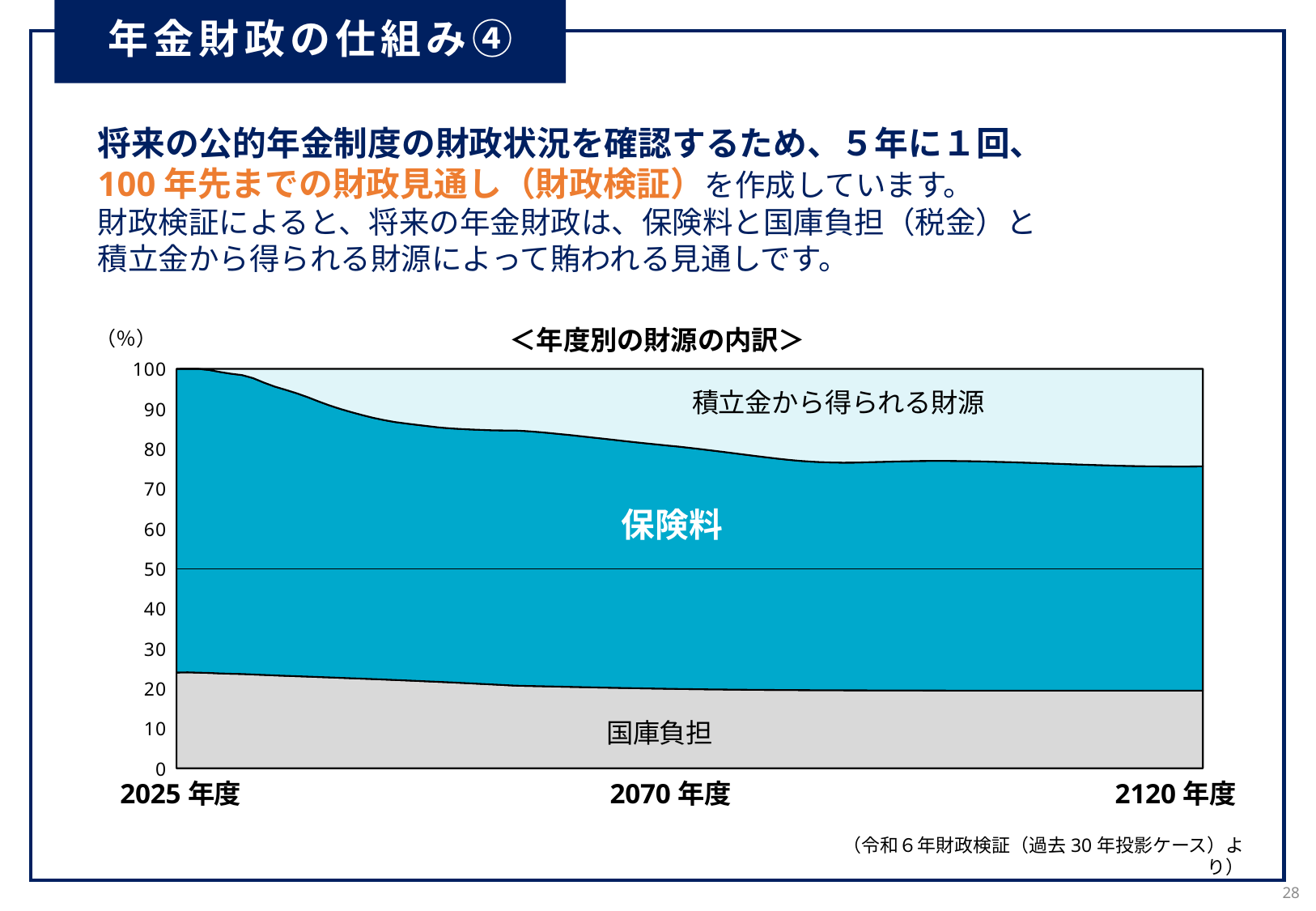
In 2120年度, which is larger: the share of 保険料 or the share of 国庫負担? 保険料 Does the share of 保険料 rise or fall from 2025年度 to 2120年度? Fall What kind of chart is shown on the slide? Stacked area chart Is the share of 国庫負担 in 2025年度 greater or less than 20%? greater Which funding source occupies the largest share of the chart area across the years? 保険料 Is the share of 積立金から得られる財源 in 2120年度 greater or less than 20%? greater What is the unit shown on the vertical axis of the chart? % How many funding sources (series) are shown in the chart? 3 Is the combined share of 国庫負担 and 保険料 in 2120年度 greater or less than 80%? less What is the title of the chart? ＜年度別の財源の内訳＞ Does the share of 積立金から得られる財源 rise or fall from 2025年度 to 2120年度? Rise Which funding source is shown at the bottom of the stacked area chart? 国庫負担